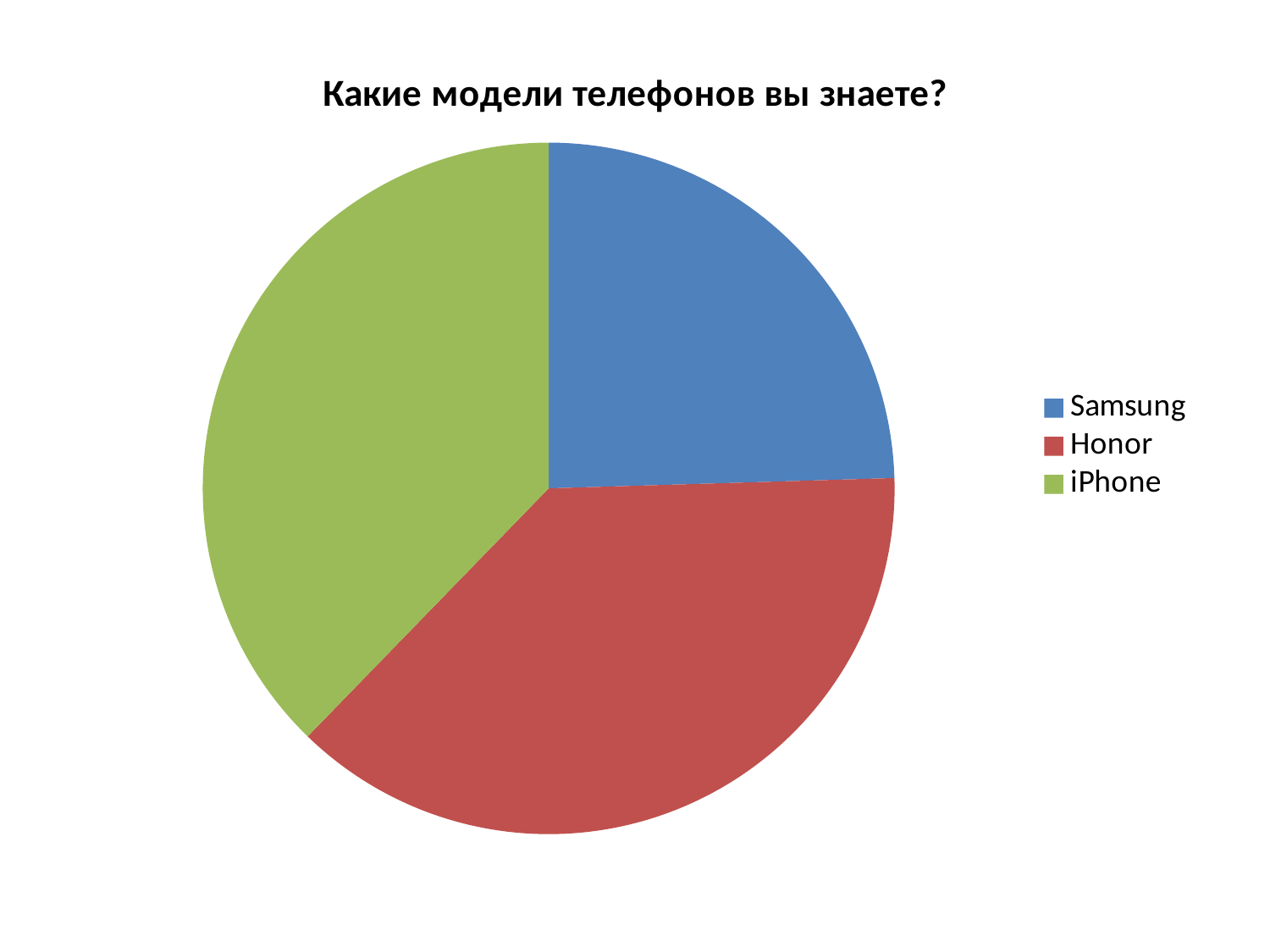
What is the title of the chart? Какие модели телефонов вы знаете? Which slice is larger, Samsung or iPhone? iPhone What kind of chart is shown on the slide? pie chart How many entries does the legend list? 3 Which slice is larger, Samsung or Honor? Honor How many slices does the pie chart have? 3 What colour is the Honor slice? red Which category has the smallest slice of the pie? Samsung